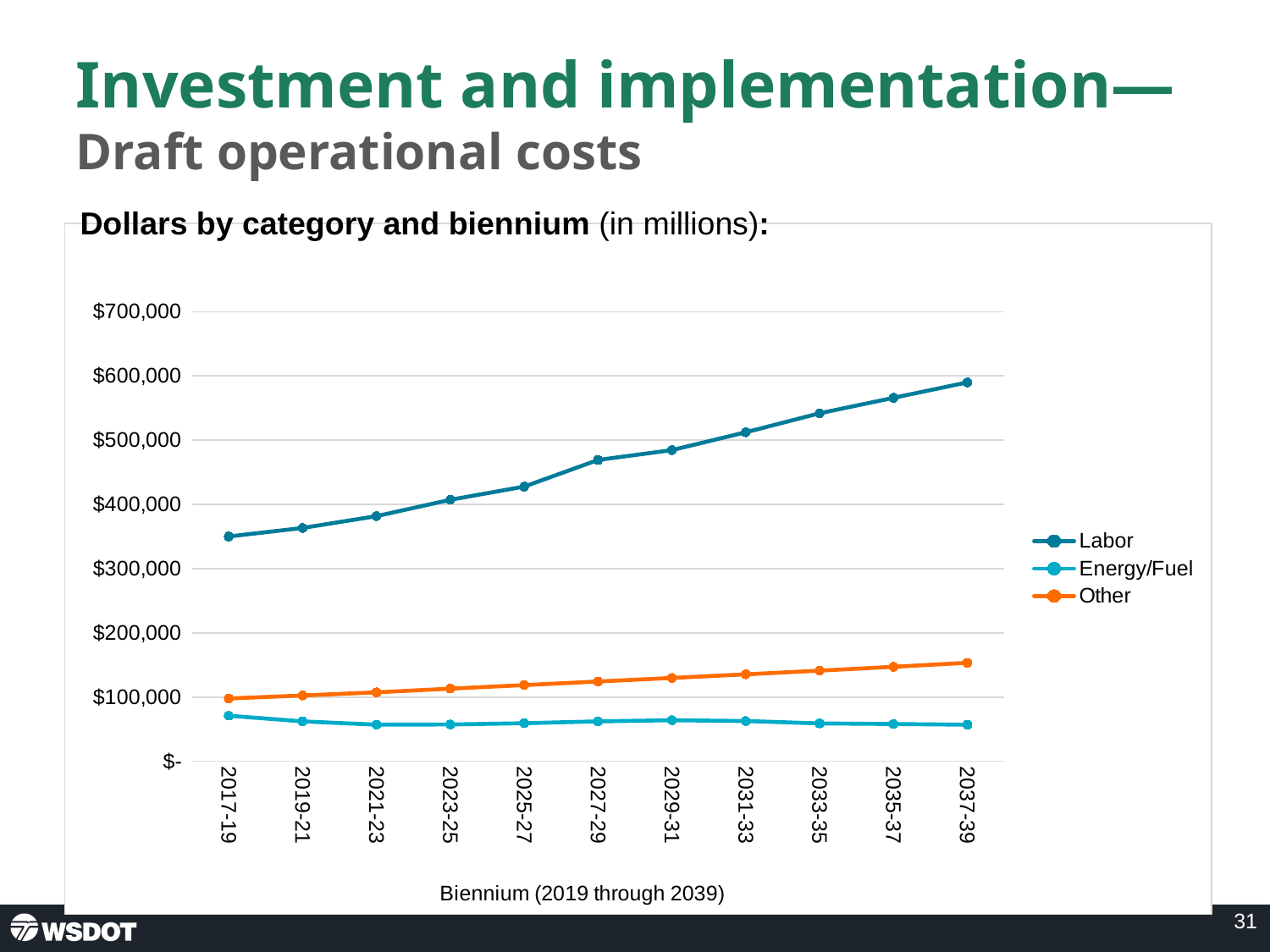
What is the x-axis label of the chart? Biennium (2019 through 2039) Which is larger in 2037-39, the Other value or the Energy/Fuel value? Other Is the Energy/Fuel value for 2017-19 greater or less than $100,000? less Do the Other values rise or fall from 2017-19 to 2037-39? rise How many bienniums are plotted along the x axis? 11 Is the Labor value for 2027-29 greater or less than $500,000? less Is the Labor value for 2017-19 greater or less than $300,000? greater Which series has the lowest value in the 2017-19 biennium? Energy/Fuel What kind of chart is shown on the slide? line chart How many series does the legend list? 3 Which series has the highest value in the 2037-39 biennium? Labor Do the Labor values rise or fall from 2017-19 to 2037-39? rise